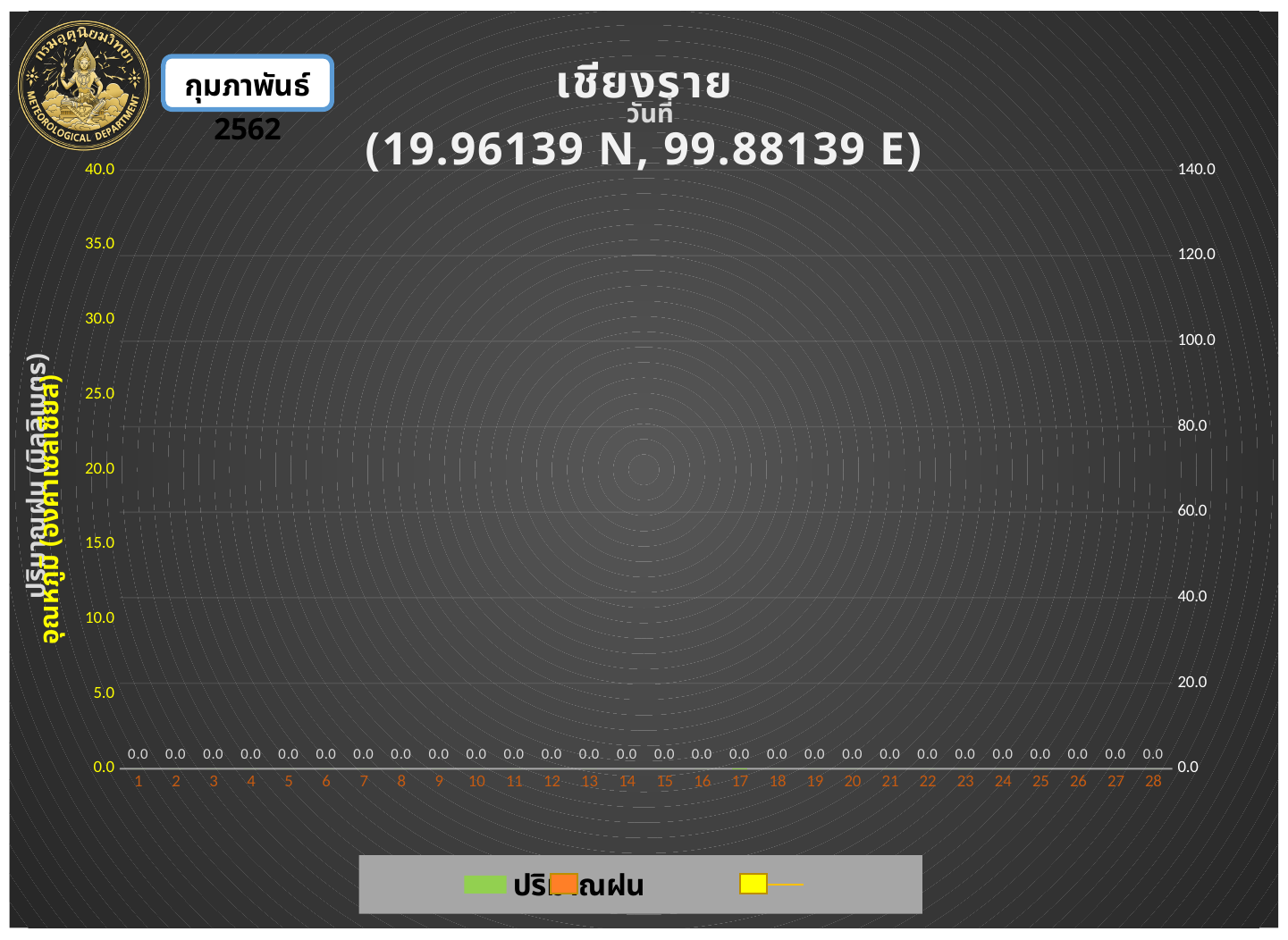
What is the first day number shown on the x axis? 1 What is the highest tick value on the right vertical axis? 140.0 What is the data label shown for day 1? 0.0 How many days are shown on the x axis of the chart? 28 Is the value for day 10 greater or less than 5.0? less What is the last day number shown on the x axis? 28 What is the data label shown for day 15? 0.0 What is the highest tick value on the left vertical axis? 40.0 What is the difference between the data labels for day 3 and day 24? 0.0 Do the data labels rise, fall, or stay the same from day 1 to day 28? stay the same Is the value for day 20 greater or less than 20.0? less What is the data label shown for day 28? 0.0